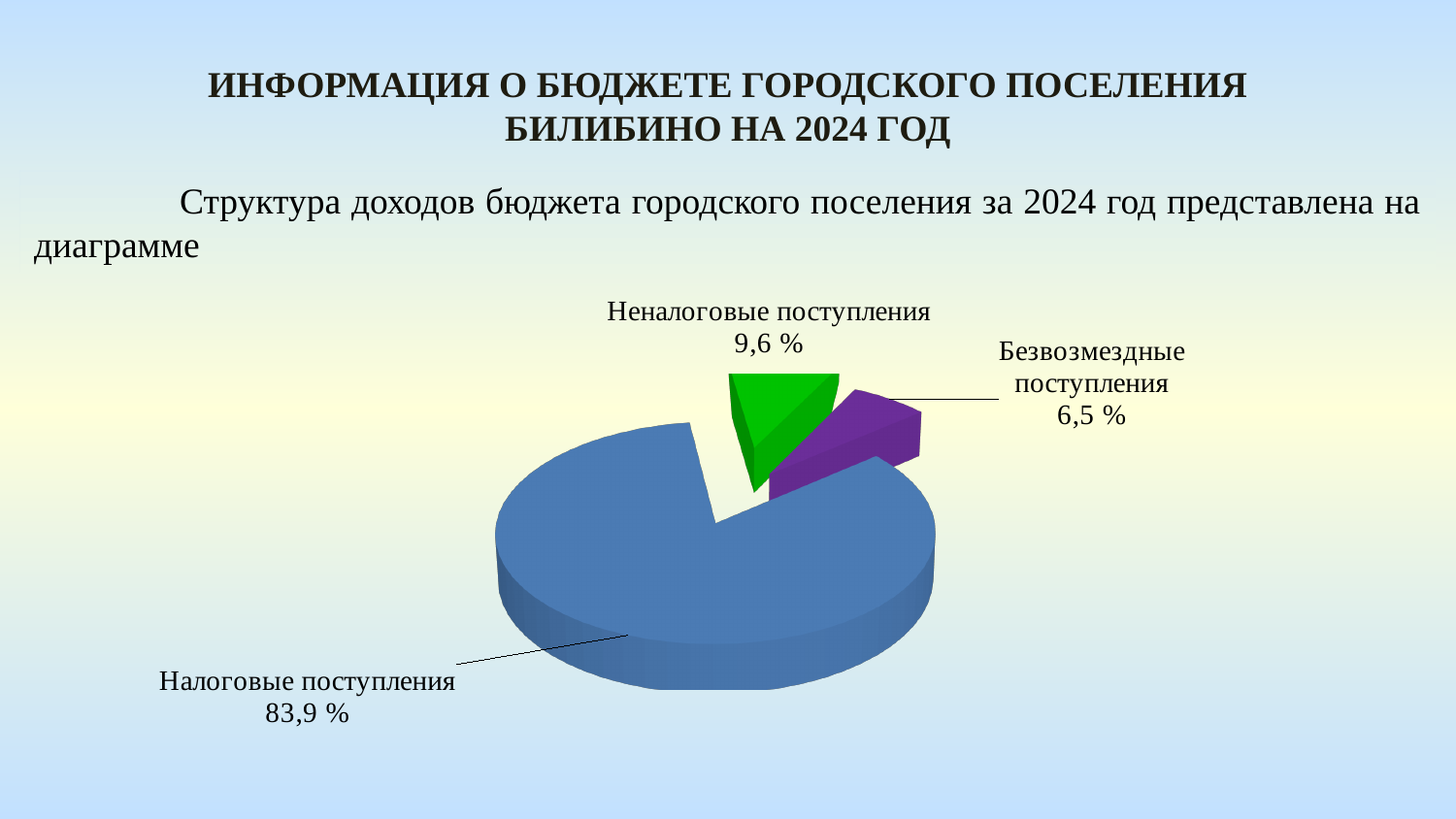
Which category has the largest slice of the pie? Налоговые поступления Which category has the smallest slice of the pie? Безвозмездные поступления What colour is the slice for Налоговые поступления? Blue How many slices does the pie chart have? 3 What is the difference between the shares of Налоговые поступления and Неналоговые поступления? 74,3 % What share of the pie does Неналоговые поступления have? 9,6 % What share of the pie does Налоговые поступления have? 83,9 % What share of the pie does Безвозмездные поступления have? 6,5 % What colour is the slice for Неналоговые поступления? Green Which is larger, Неналоговые поступления or Безвозмездные поступления? Неналоговые поступления What is the difference between the shares of Неналоговые поступления and Безвозмездные поступления? 3,1 % What kind of chart is shown on the slide? Pie chart